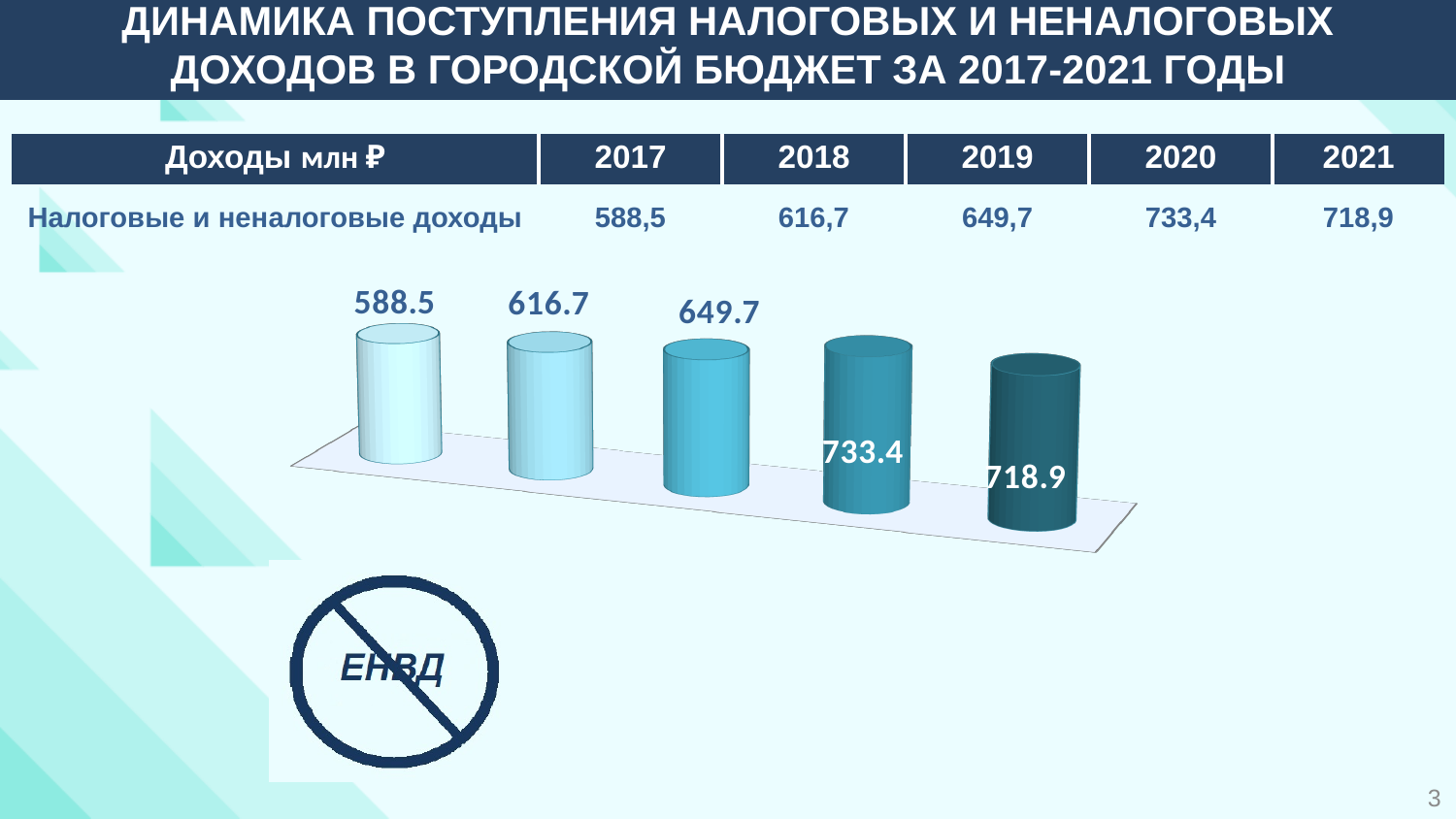
What is the value shown on the first (leftmost) bar of the chart? 588.5 Which bar in the chart has the lowest value? the first bar (588.5) What is the difference between the second bar (616.7) and the first bar (588.5) in the chart? 28.2 Which is larger in the chart: the value of the fourth bar or the value of the fifth bar? the fourth bar (733.4) What is the difference between the fourth bar (733.4) and the fifth bar (718.9) in the chart? 14.5 Do the values in the chart rise or fall from the first bar to the fourth bar? rise Which bar in the chart has the highest value? the fourth bar (733.4) According to the table, what were the tax and non-tax revenues (Налоговые и неналоговые доходы) in 2020? 733,4 What is the value shown on the third bar of the chart? 649.7 What type of chart is shown on the slide? bar chart How many bars are plotted in the chart? 5 What is the value shown on the last (rightmost) bar of the chart? 718.9